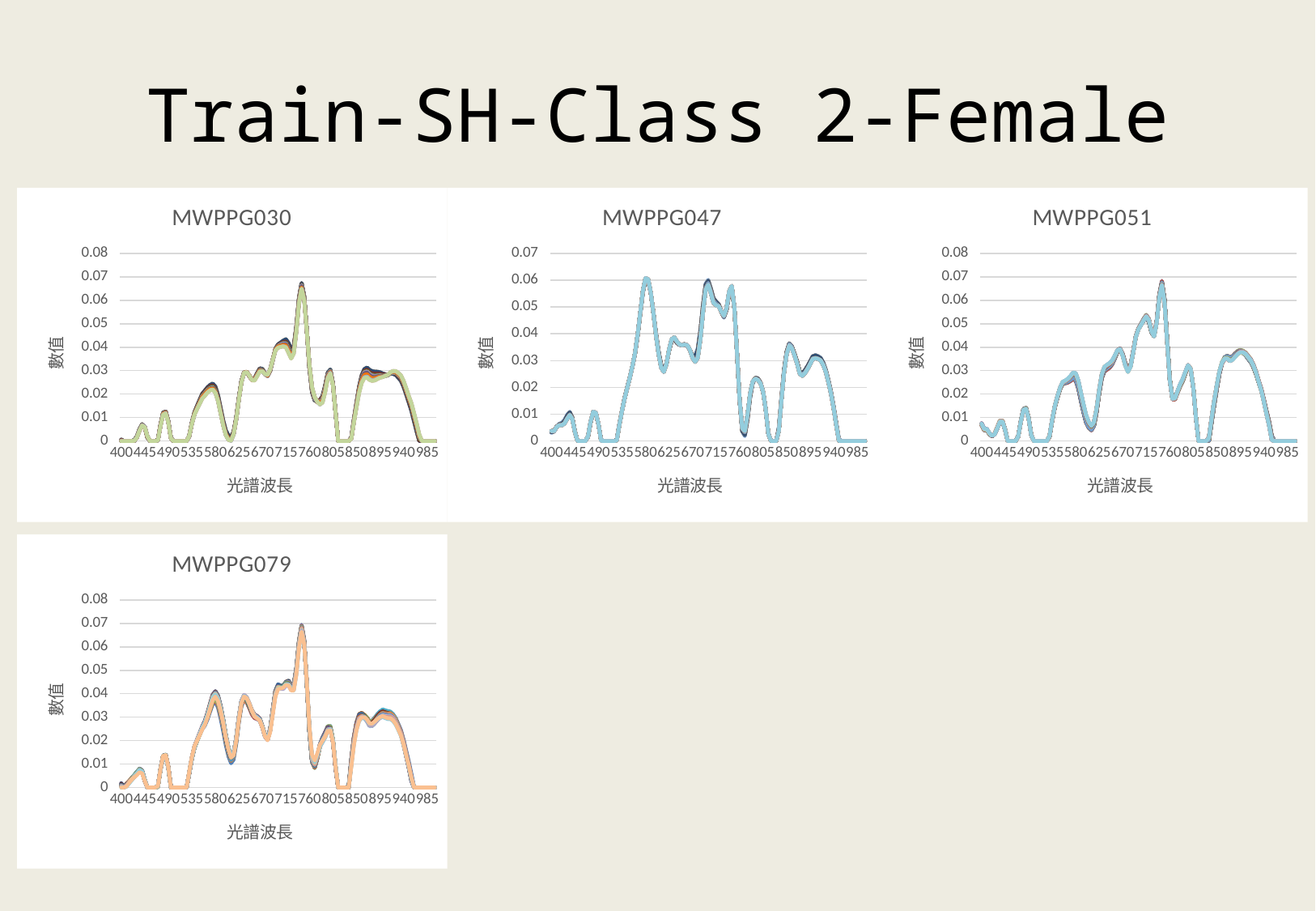
In the MWPPG051 chart, is the value at 400 greater or less than 0.02? less In the MWPPG047 chart, is the value at 400 greater or less than 0.01? less What kind of chart is MWPPG030? line chart In the MWPPG047 chart, is the peak value near 580 greater or less than 0.05? greater In the MWPPG047 chart, which is larger: the value at 580 or the value at 850? 580 What is the x-axis label of the MWPPG079 chart? 光譜波長 How many charts are shown on the slide? 4